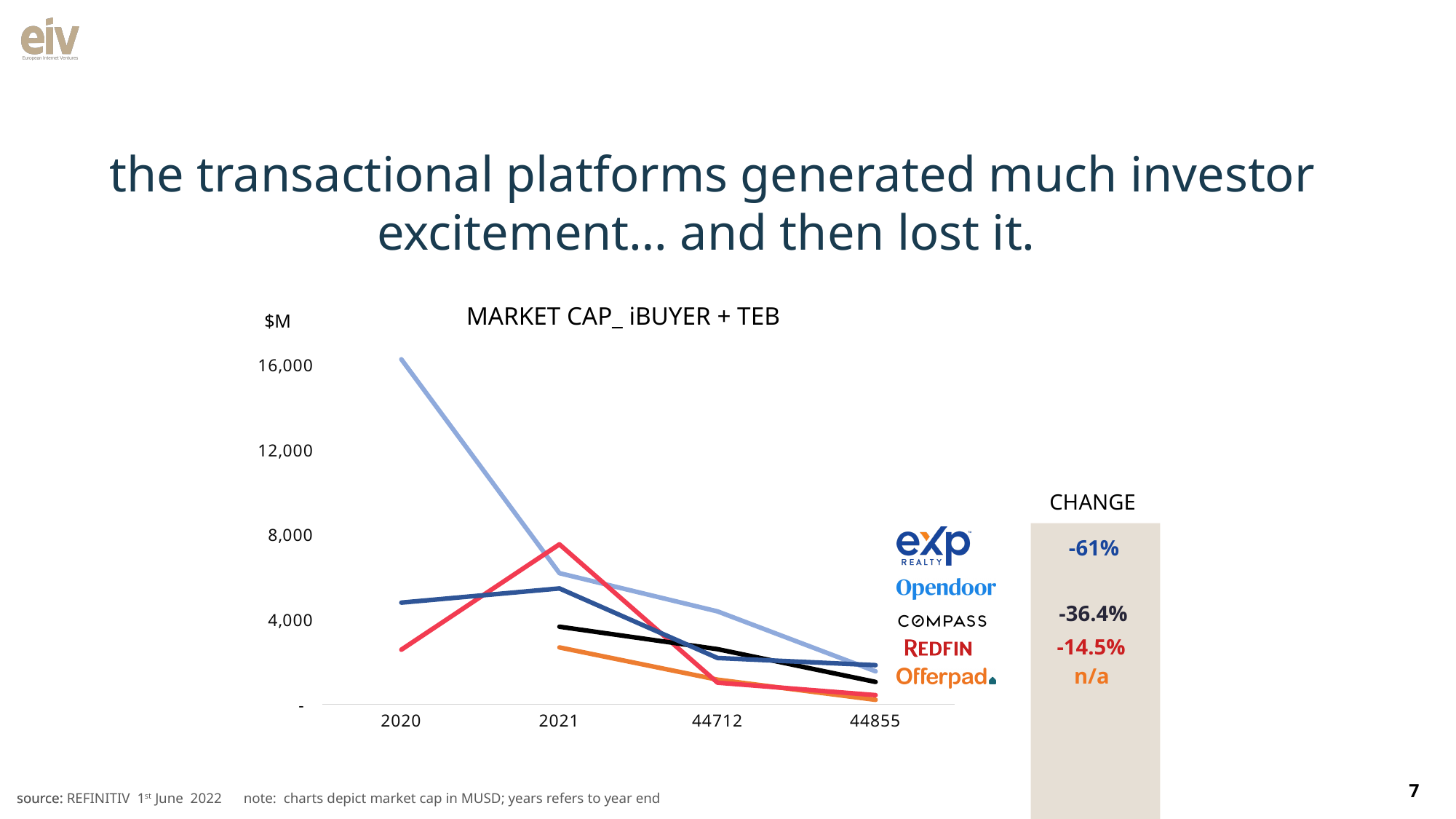
Is the market cap for Opendoor in 2020 greater or less than 12,000? greater Does the Opendoor line rise or fall from 2020 to the last point on the x axis? fall Is the market cap for Redfin in 2021 greater or less than 8,000? less Which company has the highest market cap in 2020? Opendoor What kind of chart is shown on the slide? line chart What unit is shown on the y axis of the chart? $M How many points are shown along the x axis of the chart? 4 What is the title of the chart? MARKET CAP_ iBUYER + TEB Is the market cap for Opendoor in 2021 greater or less than 4,000? greater Which company has the lowest market cap in 2020? Redfin How many company lines are plotted in the chart? 5 In 2021, which has the larger market cap, Redfin or eXp? Redfin